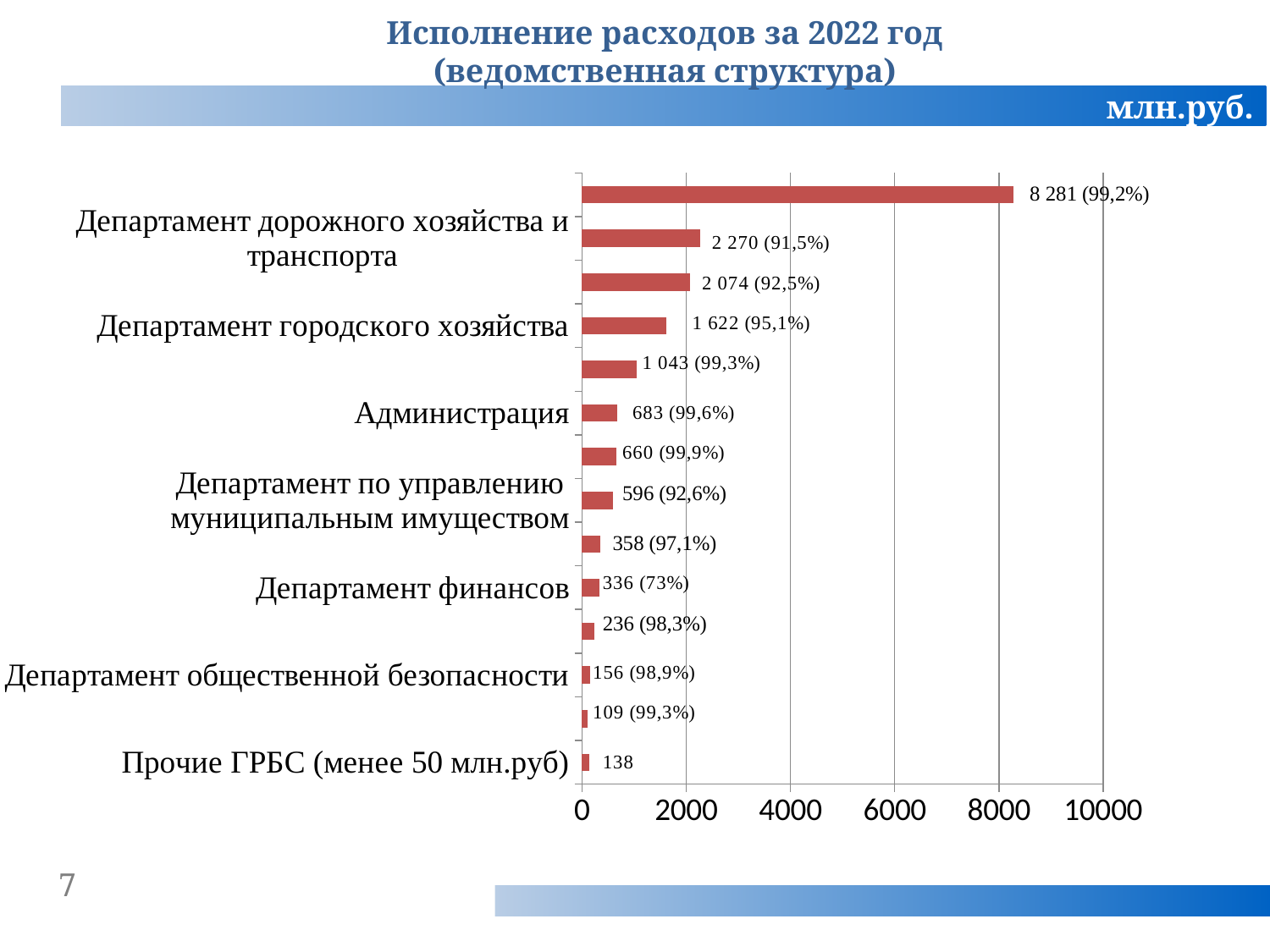
What unit of measurement is indicated for the chart values? млн.руб. Is the largest bar in the chart greater or less than 8000? greater Which is larger, the bar labelled 2 270 or the bar labelled 2 074? 2 270 How many bars are plotted in the chart? 14 What is the smallest value shown in the chart? 109 What is the difference between the largest bar (8 281) and the second largest bar (2 270)? 6 011 What is the value labelled for Прочие ГРБС (менее 50 млн.руб)? 138 What is the title of the slide's chart? Исполнение расходов за 2022 год (ведомственная структура) What kind of chart is shown on the slide? bar chart What is the value labelled for Департамент финансов? 336 (73%) What execution percentage is shown next to the value 8 281? 99,2% What is the largest value shown in the chart? 8 281